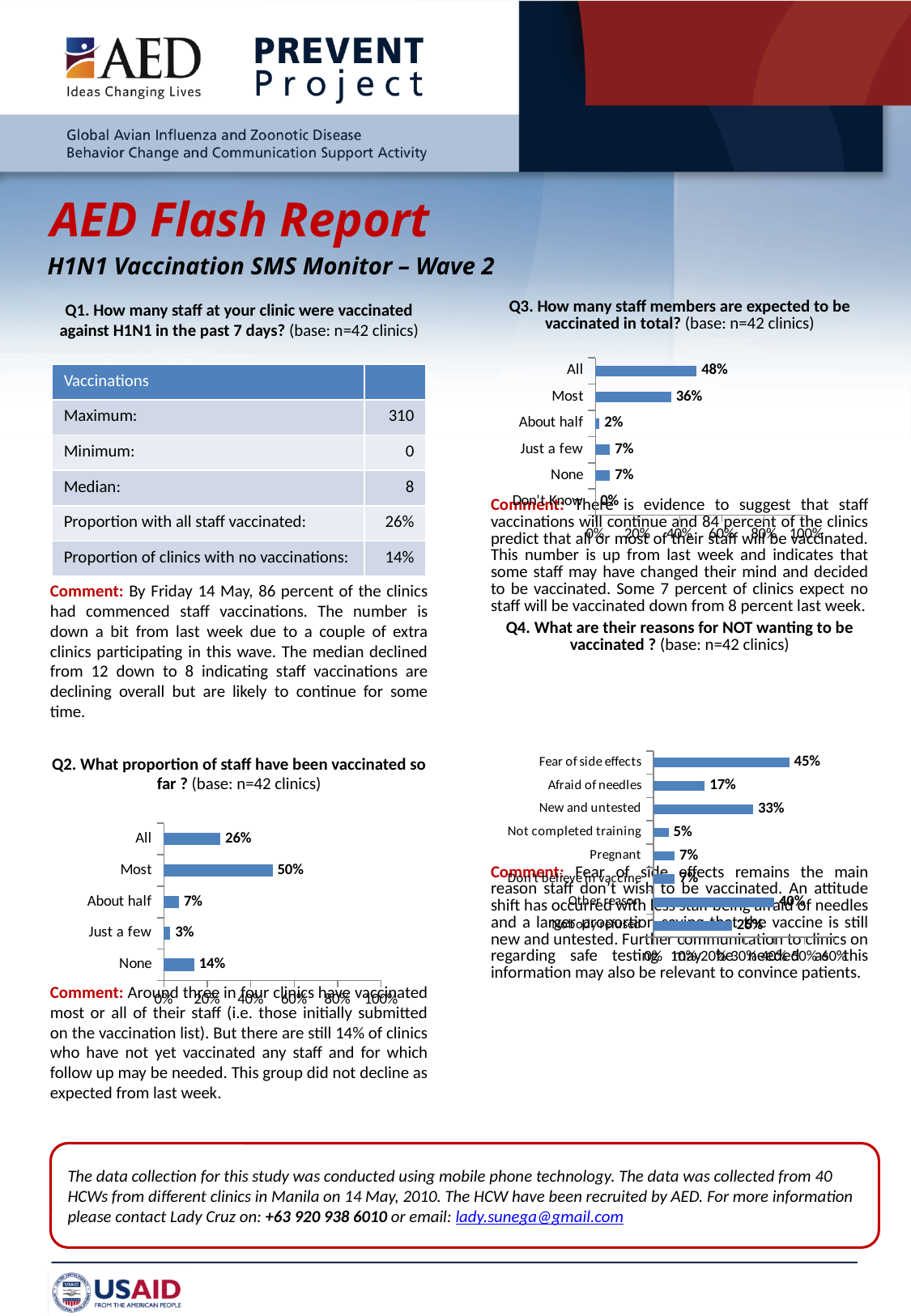
In the Q3 chart (How many staff members are expected to be vaccinated in total?), is the value for "Most" greater or less than 20%? greater In the Q4 chart (What are their reasons for NOT wanting to be vaccinated?), what is the value for "Fear of side effects"? 45% How many categories are shown in the Q2 chart (What proportion of staff have been vaccinated so far?)? 5 In the Q4 chart (What are their reasons for NOT wanting to be vaccinated?), what is the value for "Not completed training"? 5% In the Q3 chart (How many staff members are expected to be vaccinated in total?), what is the value for "About half"? 2% In the Q3 chart (How many staff members are expected to be vaccinated in total?), what is the value for "All"? 48% What type of chart is used for Q2 (What proportion of staff have been vaccinated so far?)? Bar chart In the Q4 chart (What are their reasons for NOT wanting to be vaccinated?), which is larger: "Afraid of needles" or "New and untested"? New and untested In the Q2 chart (What proportion of staff have been vaccinated so far?), what is the difference between the values for "Most" and "All"? 24% In the Q2 chart (What proportion of staff have been vaccinated so far?), what is the value for "Most"? 50% In the Q3 chart (How many staff members are expected to be vaccinated in total?), which category has the highest value? All In the Q2 chart (What proportion of staff have been vaccinated so far?), which category has the lowest value? Just a few